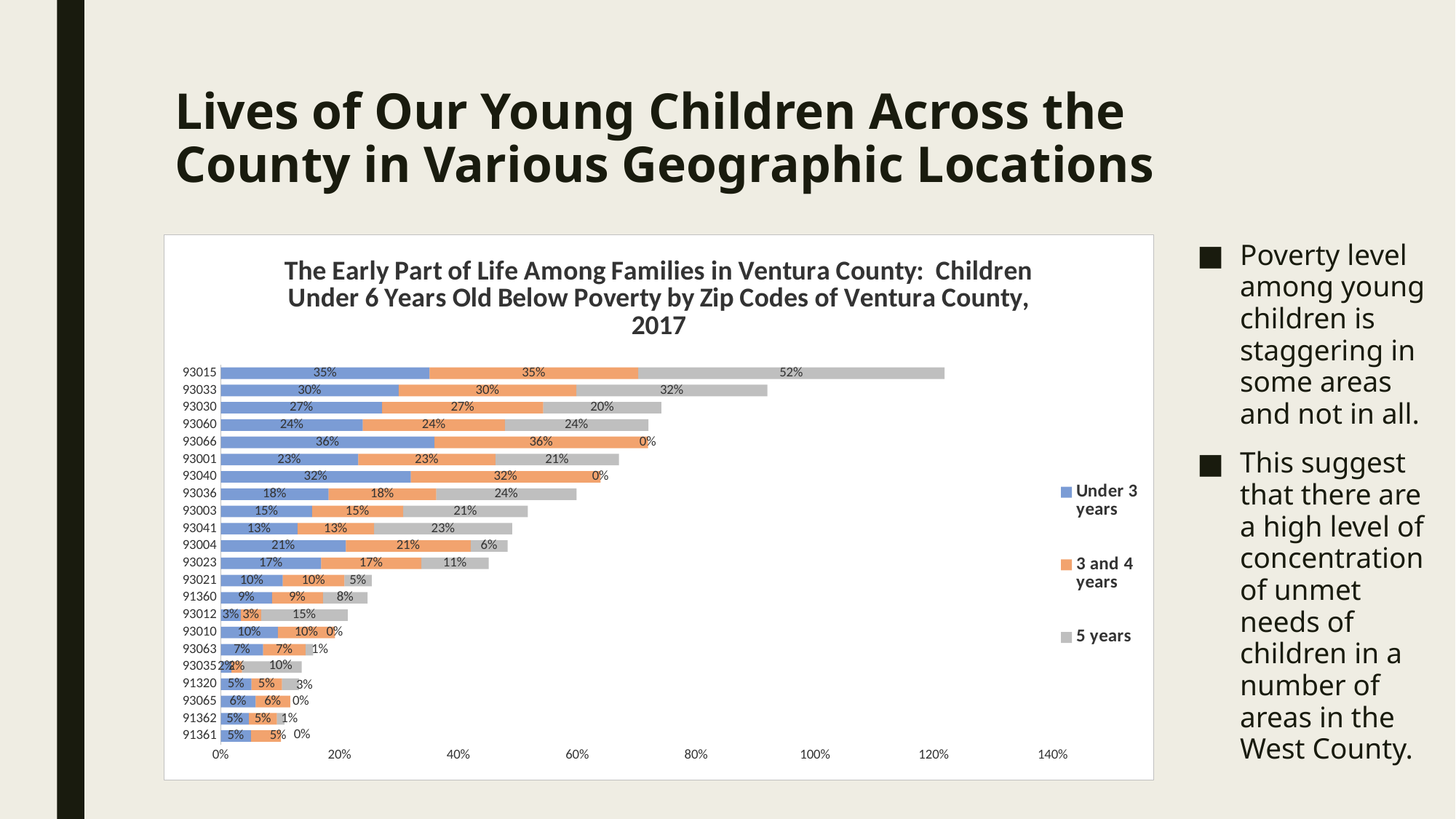
What is the total of the stacked bar for zip code 93015? 122% What are the three series named in the legend? Under 3 years, 3 and 4 years, 5 years Which zip code has the highest value for the 5 years series? 93015 What is the value for the 5 years series for zip code 93012? 15% How many zip codes are plotted on the chart? 22 What is the value for the Under 3 years series for zip code 93066? 36% What is the value for the 5 years series for zip code 93015? 52% Is the total stacked bar for zip code 93033 greater or less than 80%? greater What is the value for the 3 and 4 years series for zip code 93004? 21% What kind of chart is shown on the slide? Stacked bar chart What is the difference between the 5 years values for zip codes 93015 and 93033? 20 percentage points How many series does the legend list? 3